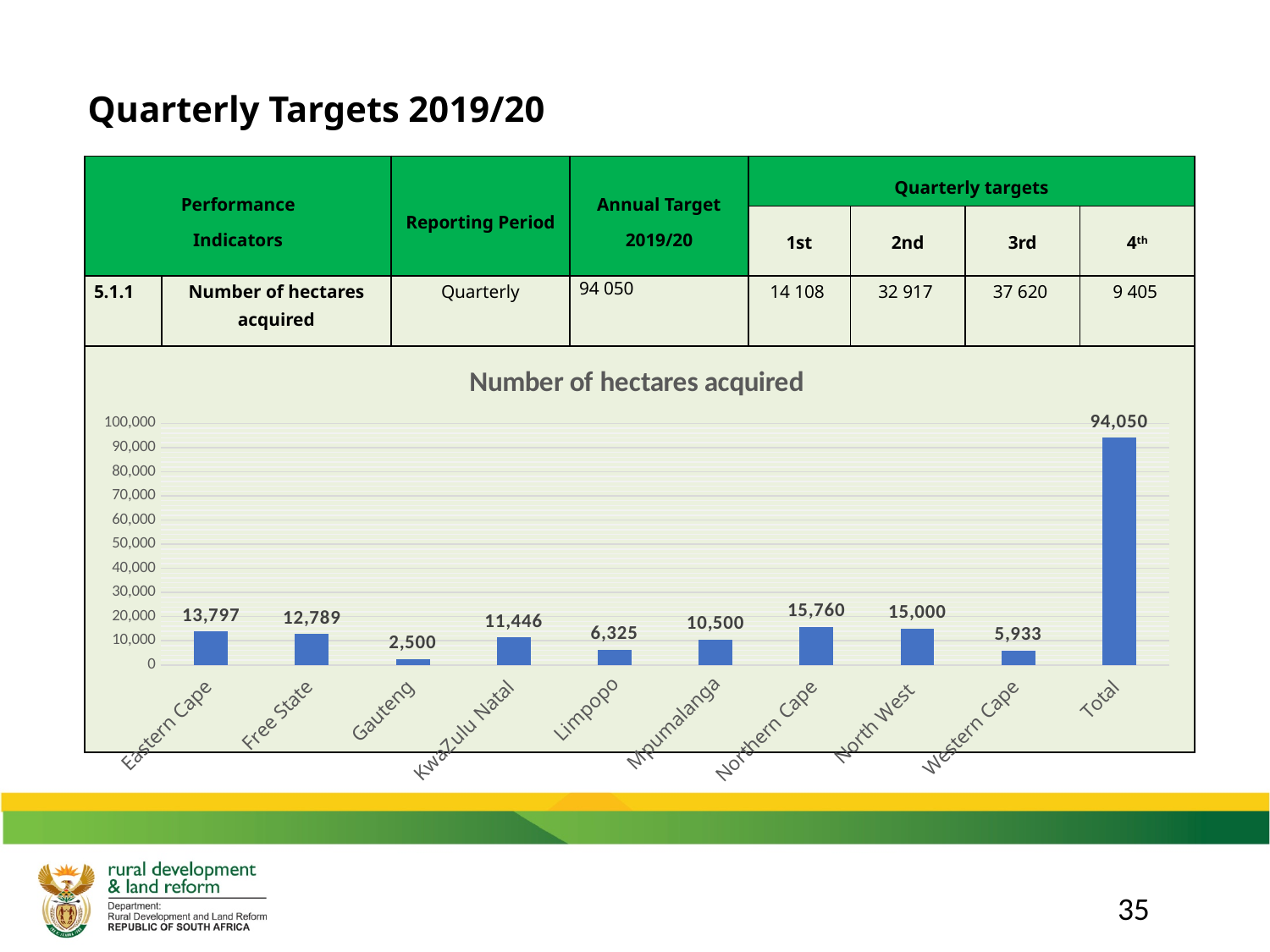
What type of chart is shown on the slide? Bar chart Which category has the lowest value in the chart? Gauteng Is the value for Mpumalanga greater or less than 20,000? less What is the difference between the values for Eastern Cape and Free State? 1,008 What is the value for Northern Cape in the chart? 15,760 What is the value for Gauteng in the chart? 2,500 What is the value for Eastern Cape in the chart? 13,797 What is the value of the Total bar in the chart? 94,050 Excluding the Total bar, which province has the highest value in the chart? Northern Cape Which is larger, the value for Limpopo or the value for Western Cape? Limpopo How many categories are shown on the x axis of the chart? 10 What is the difference between the values for Northern Cape and North West? 760